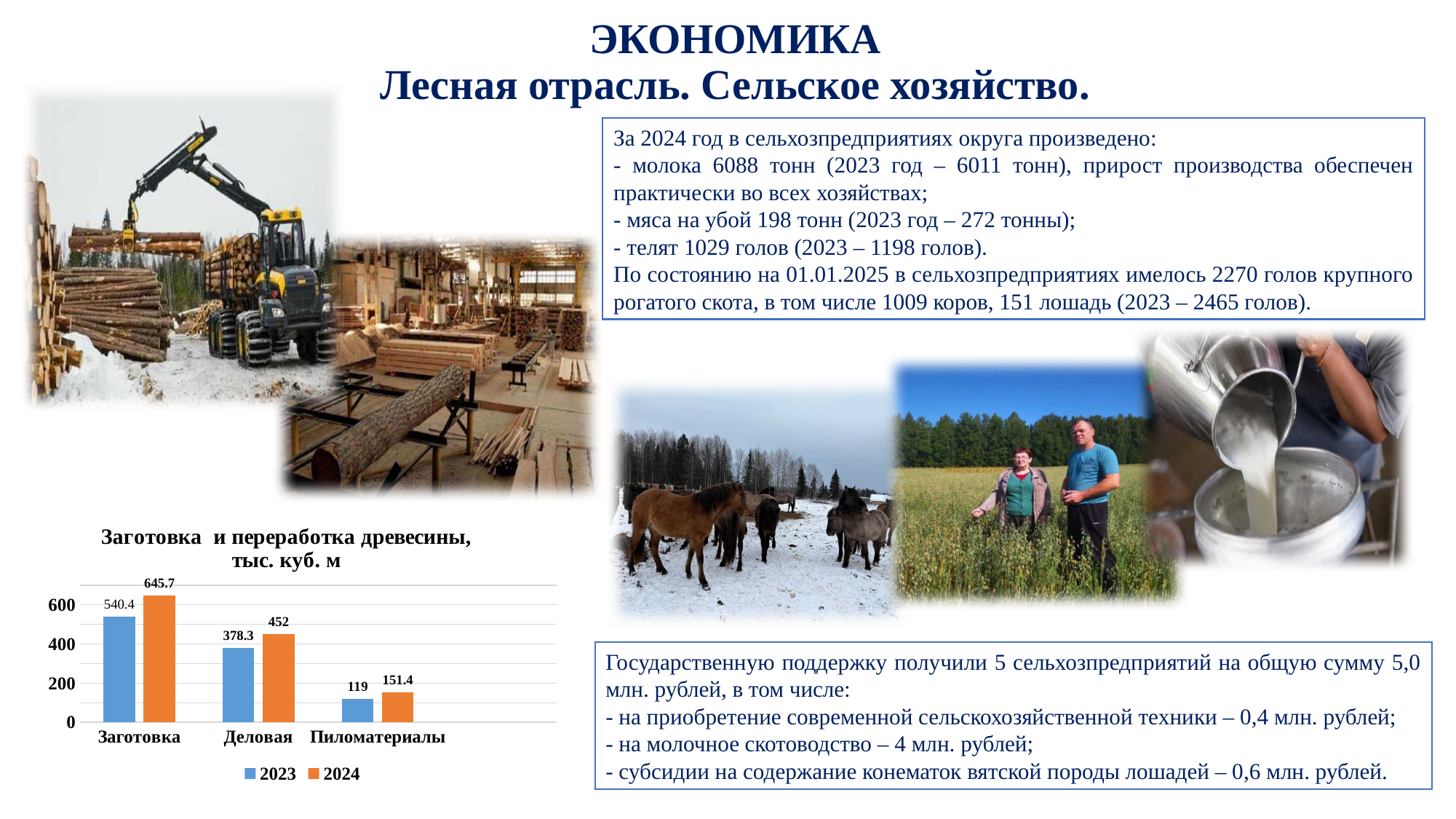
What is the difference between the 2024 and 2023 values for Деловая? 73.7 How many categories are shown on the x axis of the chart? 3 Which colour represents the 2024 series in the chart? Orange Which category has the highest 2024 value in the chart? Заготовка How many series does the chart legend list? 2 Which category has the lowest 2023 value in the chart? Пиломатериалы What is the 2024 value for Заготовка in the chart 'Заготовка и переработка древесины, тыс. куб. м'? 645.7 What is the 2024 value for Пиломатериалы in the chart? 151.4 Which is larger for Пиломатериалы: the 2023 value or the 2024 value? 2024 What is the 2023 value for Деловая in the chart? 378.3 What is the difference between the 2024 and 2023 values for Заготовка? 105.3 What type of chart is used to show 'Заготовка и переработка древесины'? Bar chart